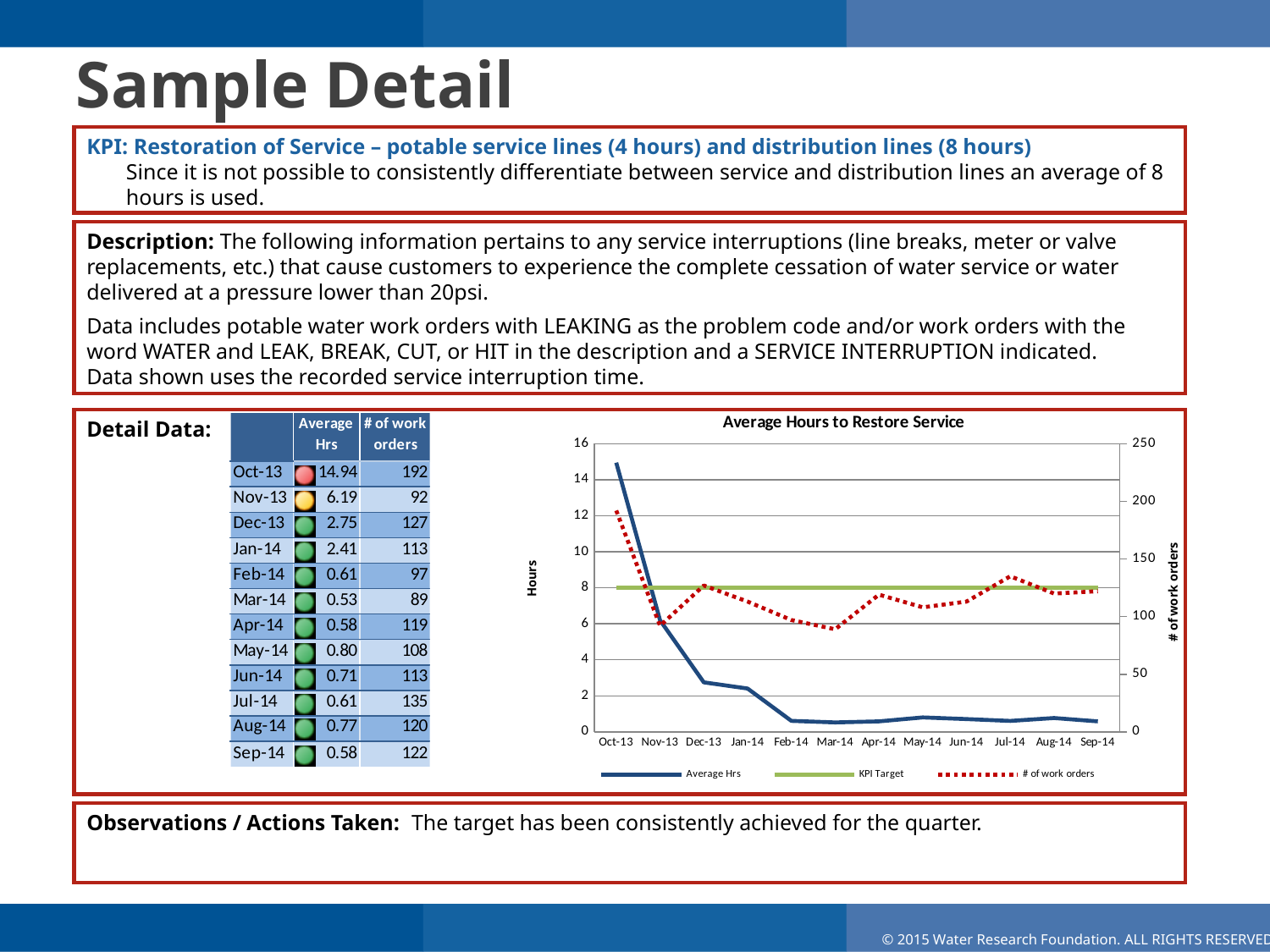
What value does the KPI Target line sit at on the Hours axis? 8 How many series does the legend of the chart list? 3 In which month is the # of work orders value lowest? Mar-14 How many months are plotted along the x axis of the chart? 12 What is the Average Hrs value for Nov-13? 6.19 What is the # of work orders value for Jul-14? 135 What is the difference in # of work orders between Oct-13 and Nov-13? 100 In which month is the Average Hrs value highest? Oct-13 What is the title of the chart? Average Hours to Restore Service What kind of chart is shown on the slide? line chart Does the Average Hrs line rise or fall from Oct-13 to Feb-14? fall Which is larger, the Average Hrs value for Dec-13 or for Jan-14? Dec-13